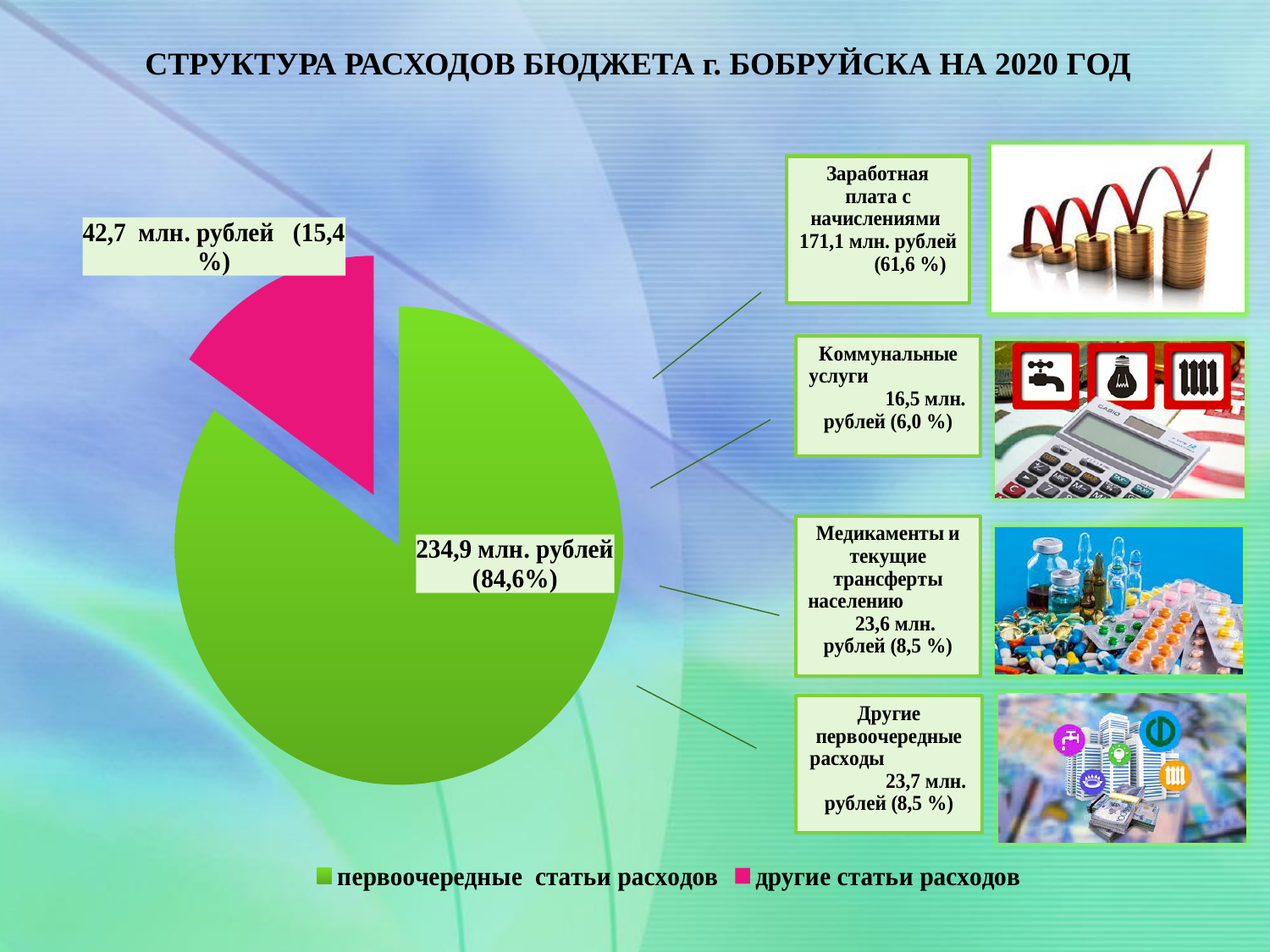
What kind of chart is shown on the slide? pie chart Which is larger: первоочередные статьи расходов or другие статьи расходов? первоочередные статьи расходов Which slice of the pie is the largest? первоочередные статьи расходов What colour is the slice for другие статьи расходов? pink What is the value shown for the pink slice (другие статьи расходов)? 42,7 млн. рублей How many entries does the legend list? 2 Which slice of the pie is the smallest? другие статьи расходов What is the difference in млн. рублей between первоочередные статьи расходов and другие статьи расходов? 192,2 млн. рублей What is the value shown for the green slice (первоочередные статьи расходов)? 234,9 млн. рублей How many slices does the pie chart have? 2 What share of the pie does the slice 'другие статьи расходов' represent? 15,4 % What share of the pie does the slice 'первоочередные статьи расходов' represent? 84,6%